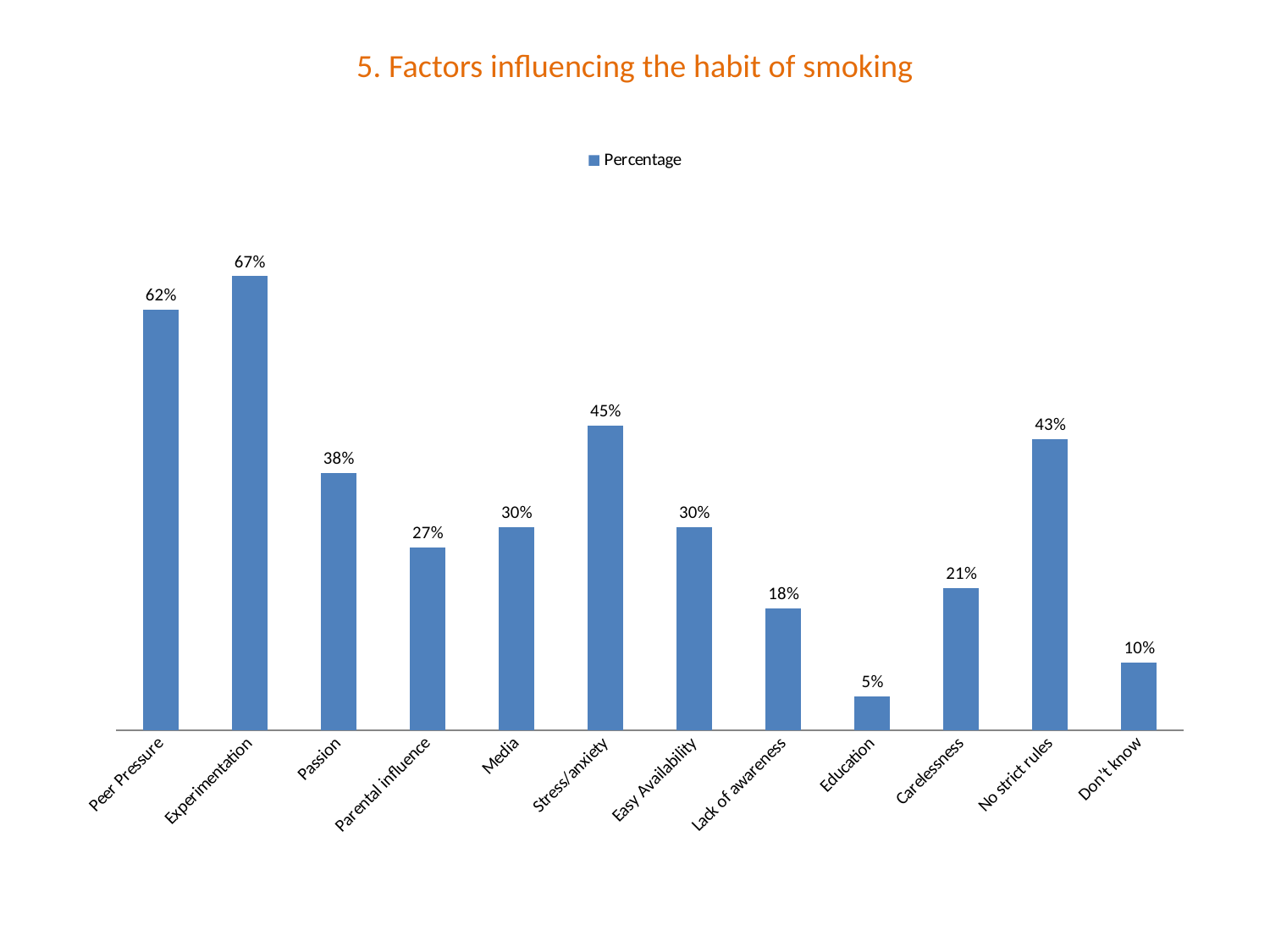
Which is larger, the percentage for Carelessness or the percentage for Lack of awareness? Carelessness What is the difference between the percentages for Experimentation and Peer Pressure? 5% Which factor has the highest percentage? Experimentation What kind of chart is shown on the slide? Bar chart Which factor has the lowest percentage? Education What is the percentage for No strict rules? 43% What is the percentage for Peer Pressure? 62% How many series does the legend list? 1 How many factors are shown on the x axis? 12 What is the difference between the percentages for Passion and Parental influence? 11% What is the percentage for Stress/anxiety? 45% What is the title of the chart? 5. Factors influencing the habit of smoking